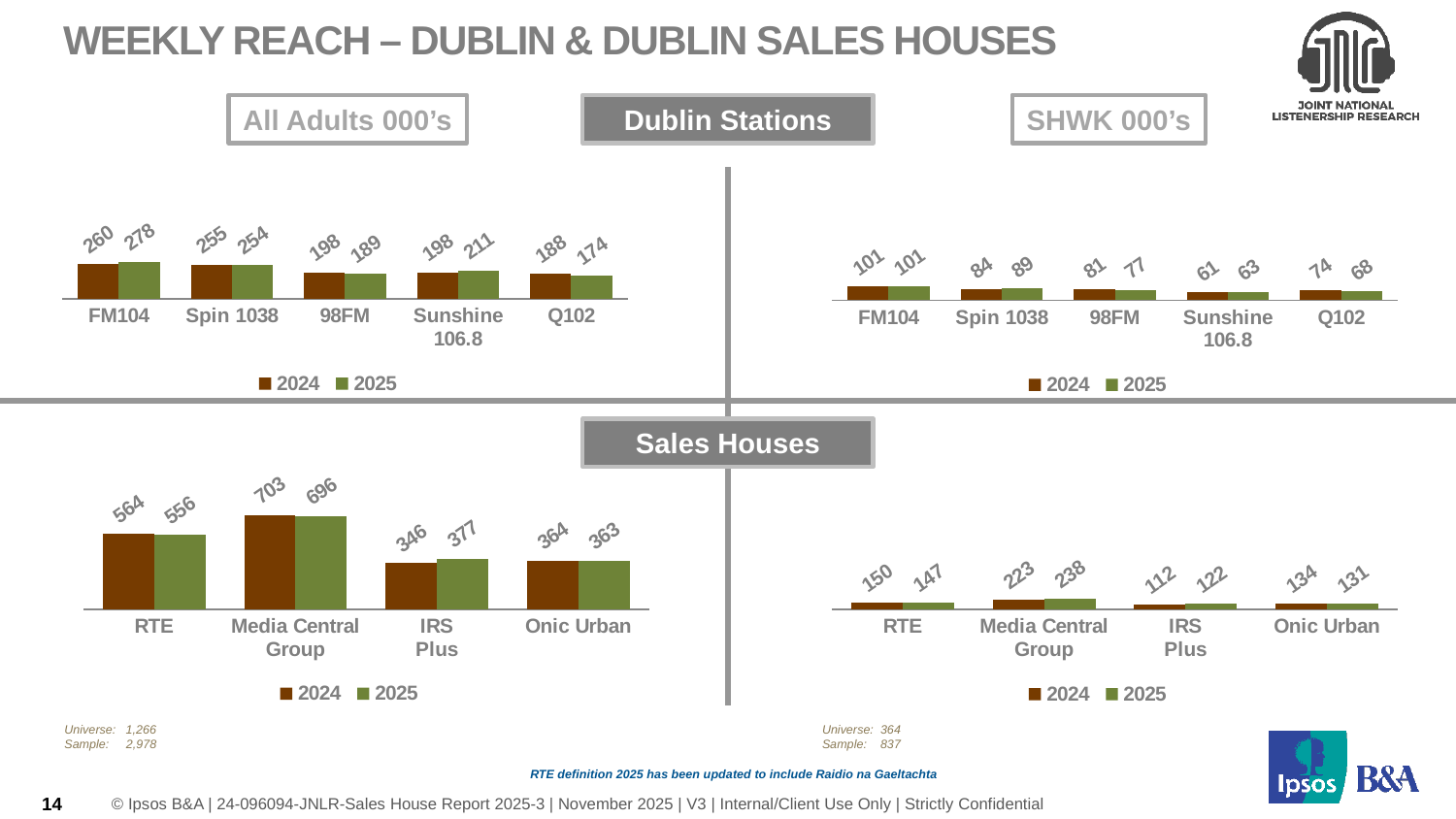
In the top-right chart (SHWK 000's, Dublin Stations), which station has the highest 2025 value? FM104 In the bottom-right chart (SHWK 000's, Sales Houses), what is the 2025 value for Media Central Group? 238 In the top-left chart (All Adults 000's, Dublin Stations), what is the 2025 value for FM104? 278 In the bottom-right chart (SHWK 000's, Sales Houses), what is the difference between the 2025 and 2024 values for IRS Plus? 10 In the top-left chart (All Adults 000's, Dublin Stations), what is the difference between the 2024 and 2025 values for Sunshine 106.8? 13 In the top-right chart (SHWK 000's, Dublin Stations), what is the 2024 value for 98FM? 81 In the top-right chart (SHWK 000's, Dublin Stations), how many stations are shown? 5 In the top-left chart (All Adults 000's, Dublin Stations), which station has the lowest 2025 value? Q102 In the bottom-left chart (All Adults 000's, Sales Houses), what is the 2024 value for Media Central Group? 703 How many series does the legend list in the bottom-right chart (SHWK 000's, Sales Houses)? 2 In the bottom-left chart (All Adults 000's, Sales Houses), is the 2025 value for IRS Plus larger or smaller than the 2025 value for Onic Urban? larger In the bottom-left chart (All Adults 000's, Sales Houses), which sales house has the lowest 2024 value? IRS Plus